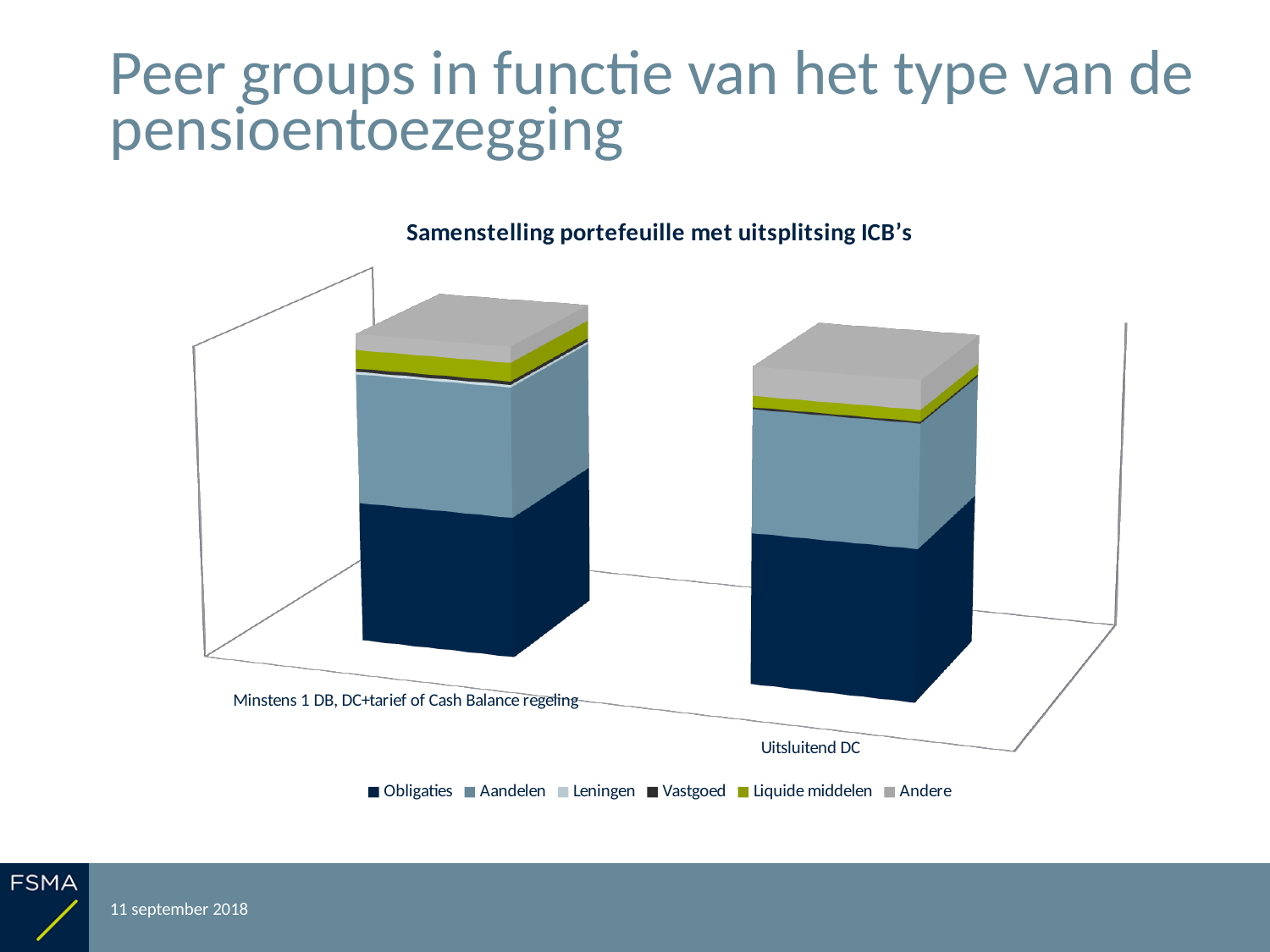
Which series forms the second-largest segment of the bar for 'Uitsluitend DC'? Aandelen Which series is listed first in the legend? Obligaties Which series makes up the largest segment of the bar for 'Uitsluitend DC'? Obligaties How many categories (bars) are shown in the chart? 2 What kind of chart is shown on the slide? Stacked bar chart Which category has the larger 'Andere' segment: 'Minstens 1 DB, DC+tarief of Cash Balance regeling' or 'Uitsluitend DC'? Uitsluitend DC What is the label of the category shown on the right of the chart? Uitsluitend DC What is the label of the category shown on the left of the chart? Minstens 1 DB, DC+tarief of Cash Balance regeling Which series makes up the largest segment of the bar for 'Minstens 1 DB, DC+tarief of Cash Balance regeling'? Obligaties How many series does the legend list? 6 What is the title of the chart? Samenstelling portefeuille met uitsplitsing ICB’s